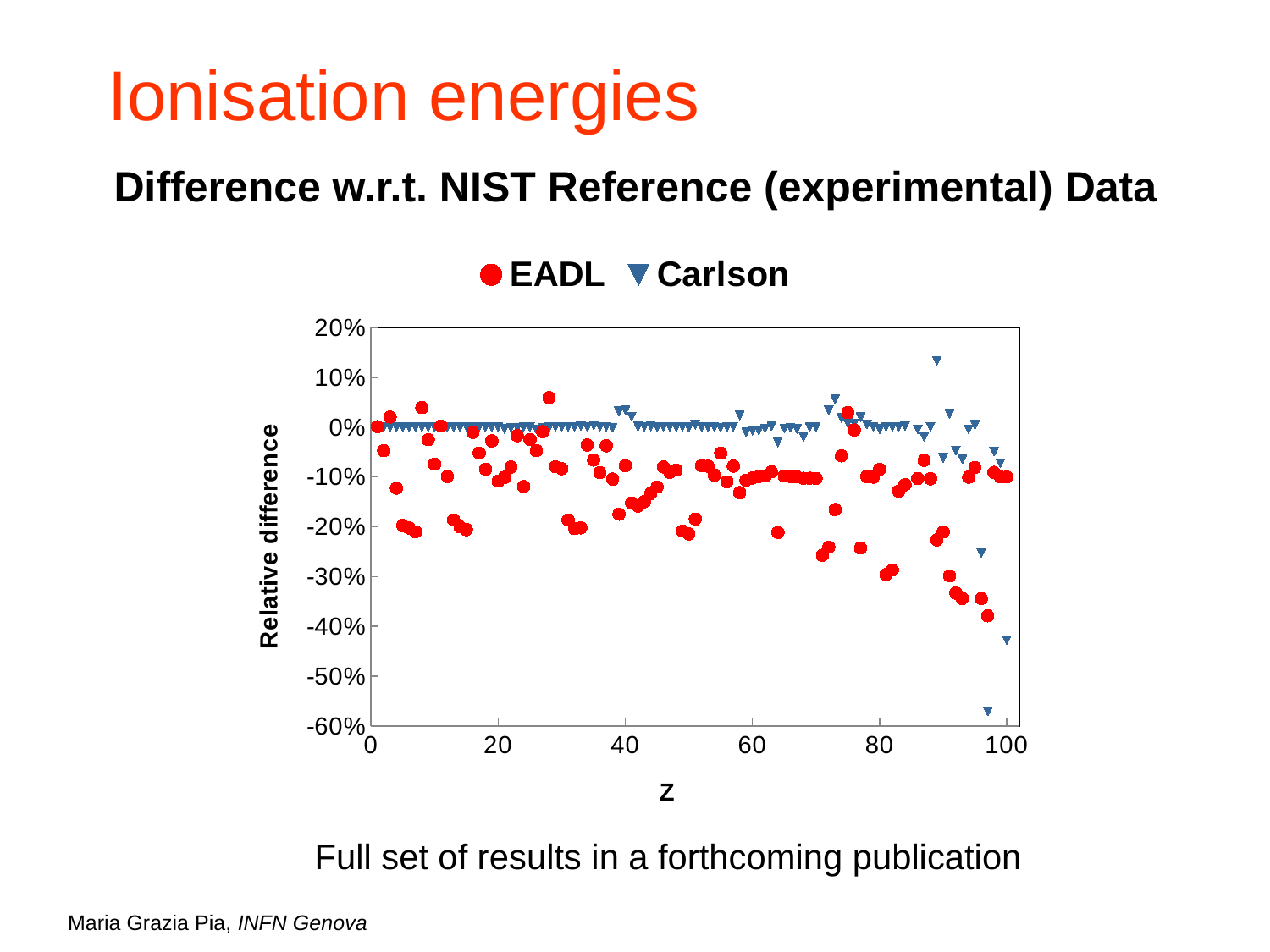
How many series does the legend list? 2 Which series stays closer to 0% across most of the Z range, EADL or Carlson? Carlson Is the highest Carlson value greater or less than 10%? greater What kind of chart is shown on the slide? scatter chart Is the lowest EADL value greater or less than -50%? greater Is the highest EADL value greater or less than 10%? less Which series contains the single lowest point on the chart? Carlson Which series contains the single highest point on the chart? Carlson What are the two series named in the legend? EADL and Carlson What is the label of the vertical axis? Relative difference